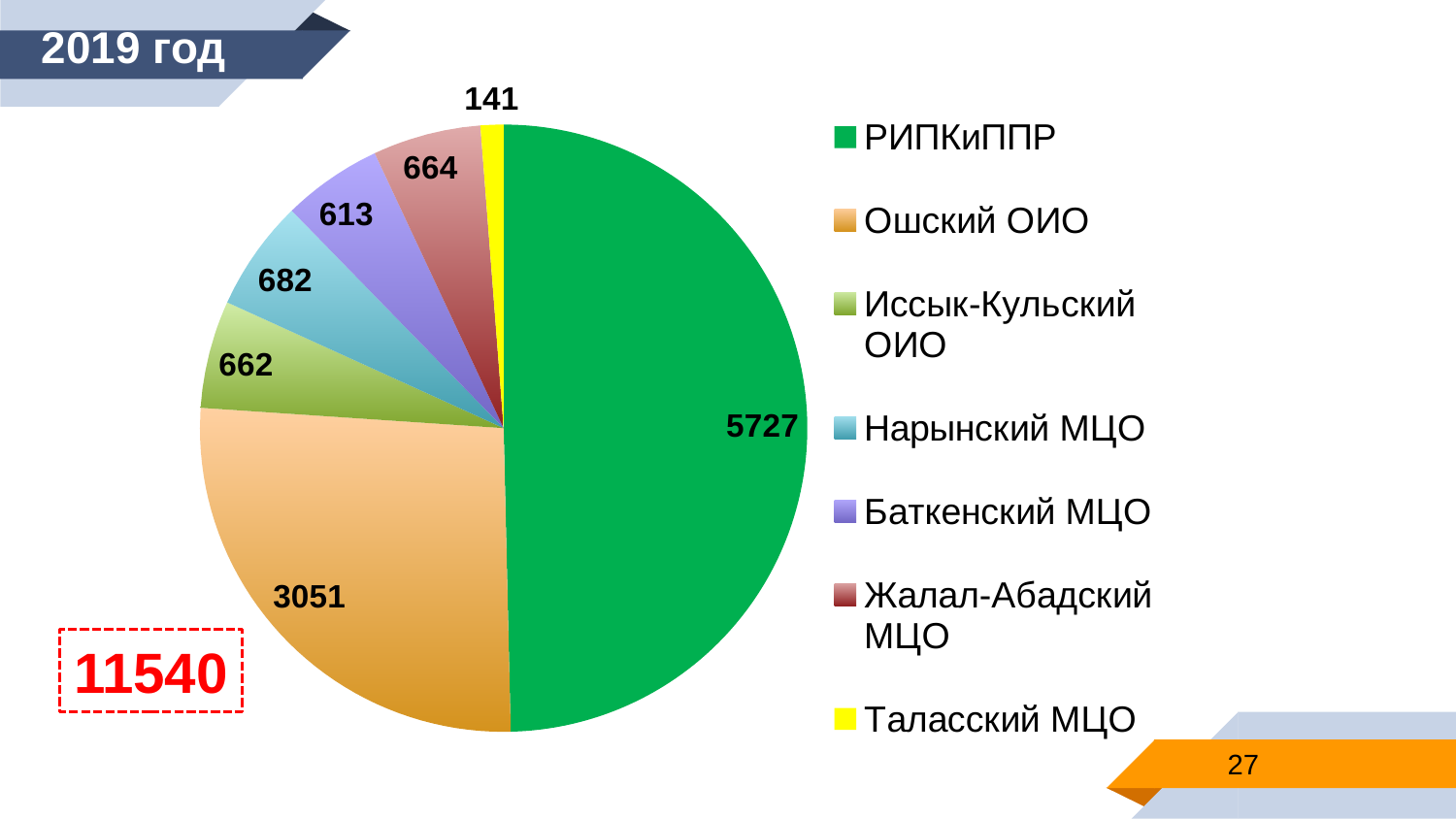
What value is shown for РИПКиППР in the pie chart? 5727 What is the difference between the values for РИПКиППР and Ошский ОИО? 2676 What year is indicated in the slide header? 2019 год What value is shown for Ошский ОИО? 3051 How many slices does the pie chart have? 7 Which category has the largest slice of the pie? РИПКиППР What type of chart is shown on the slide? pie chart What value is shown for Таласский МЦО? 141 What total is shown in the red dashed box on the slide? 11540 What value is shown for Нарынский МЦО? 682 Which category has the smallest slice of the pie? Таласский МЦО Which is larger, the value for Нарынский МЦО or Баткенский МЦО? Нарынский МЦО